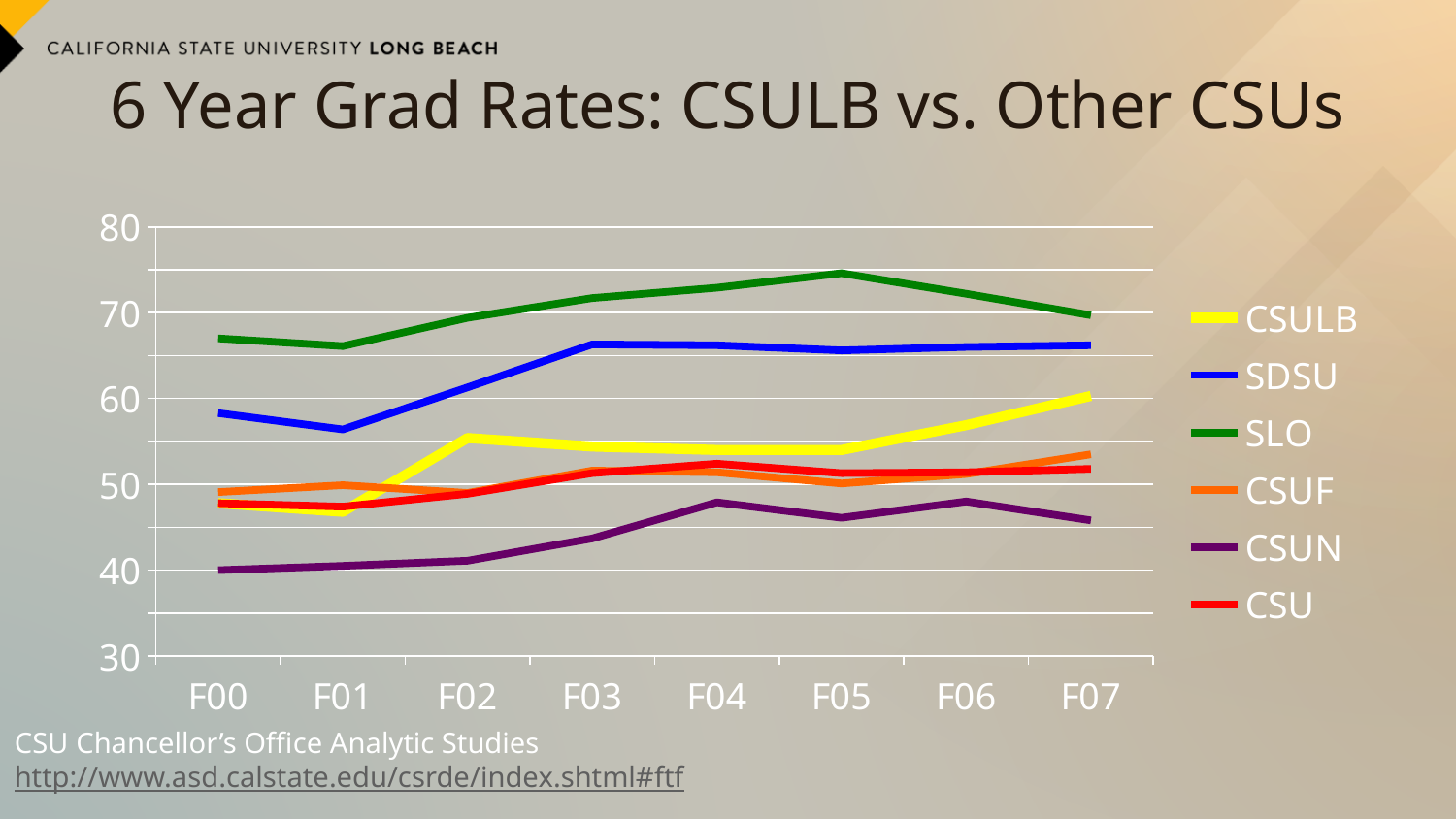
How many series does the legend list? 6 Which series has the lowest value at F00? CSUN How many cohort years are plotted along the x axis? 8 At F07, which is larger, the value for SDSU or the value for CSULB? SDSU Is the value for CSULB at F01 greater or less than 50? less Which series has the highest value at F05? SLO What kind of chart is shown on the slide? line chart Does the SLO line rise or fall from F05 to F07? fall Is the value for CSUN at F00 greater or less than 50? less Is the value for SLO at F05 greater or less than 70? greater At F02, which is larger, the value for CSULB or the value for CSUF? CSULB What colour is the CSULB line in the legend? yellow